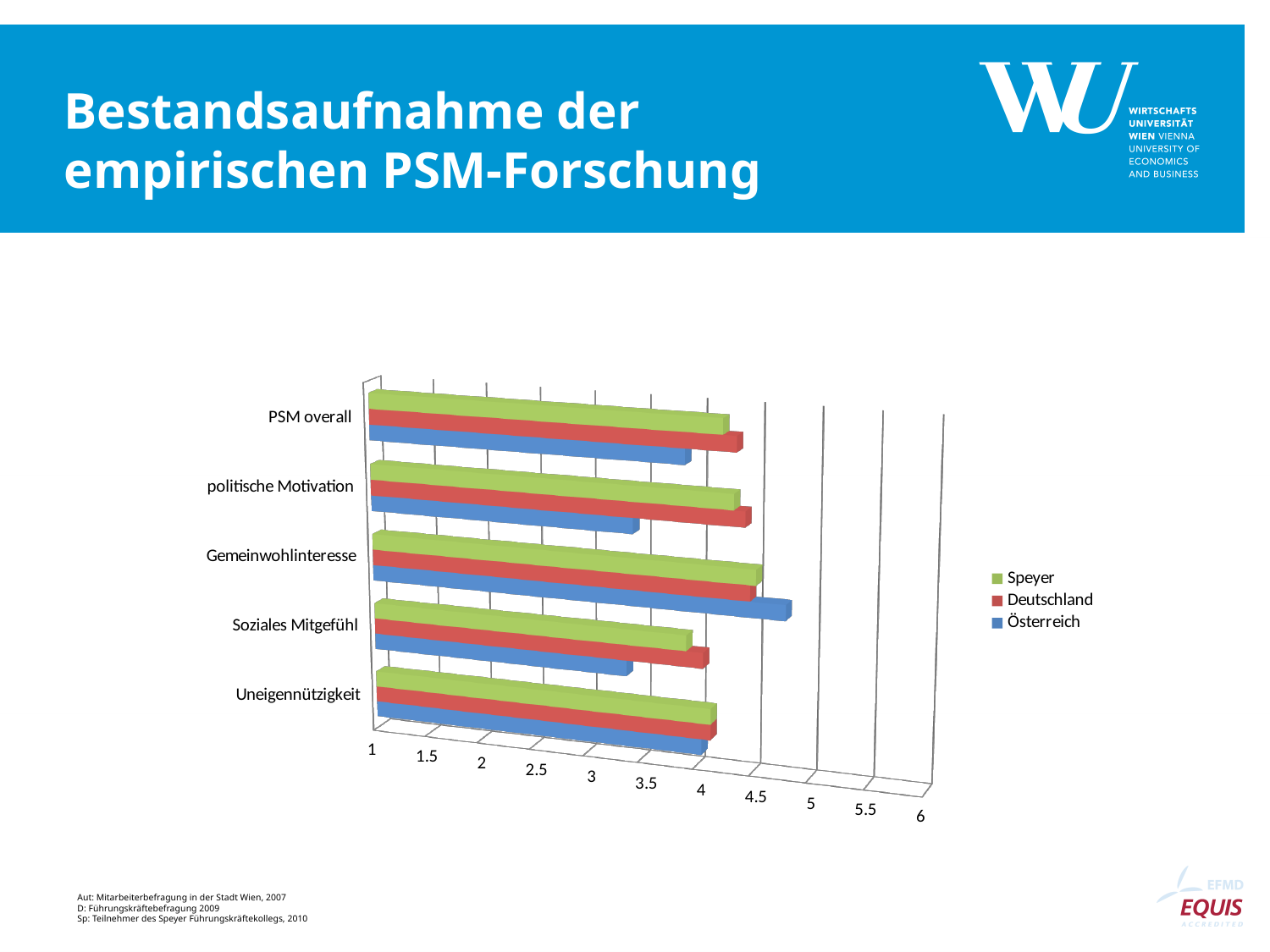
Which series are listed in the chart's legend? Speyer, Deutschland, Österreich What kind of chart is shown on the slide? bar chart Is the Österreich value for Gemeinwohlinteresse greater or less than 4? greater Which series has the highest value for Gemeinwohlinteresse? Österreich For politische Motivation, which is larger: the Deutschland value or the Österreich value? Deutschland How many series does the chart's legend list? 3 How many categories are plotted on the chart? 5 Is the Österreich value for politische Motivation greater or less than 4? less Is the Österreich value for Soziales Mitgefühl greater or less than 4? less For which category is the Österreich value highest? Gemeinwohlinteresse For Soziales Mitgefühl, which is larger: the Deutschland value or the Österreich value? Deutschland Which colour represents the Speyer series in the chart? green